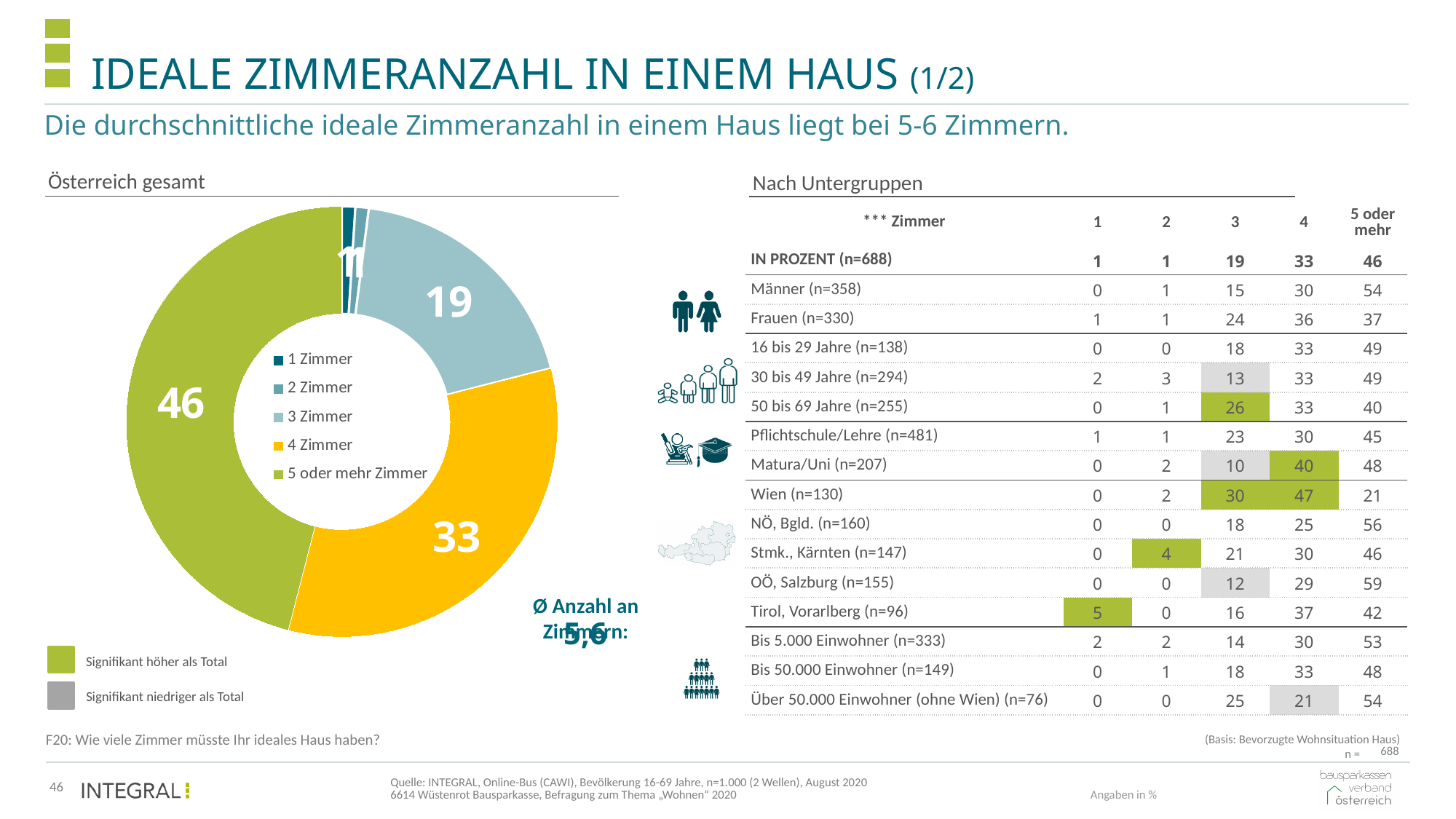
In the "Österreich gesamt" chart, what is the value for "3 Zimmer"? 19 In the "Österreich gesamt" chart, which category is larger: "3 Zimmer" or "4 Zimmer"? 4 Zimmer What average number of rooms (Ø Anzahl an Zimmern) is stated next to the "Österreich gesamt" chart? 5,6 In the "Österreich gesamt" chart, what is the difference between the values for "4 Zimmer" and "3 Zimmer"? 14 In the "Österreich gesamt" chart, what is the value for "5 oder mehr Zimmer"? 46 In the "Österreich gesamt" chart, what is the difference between the values for "5 oder mehr Zimmer" and "4 Zimmer"? 13 In the "Österreich gesamt" chart, what is the value for "1 Zimmer"? 1 In the "Österreich gesamt" chart, which category has the largest share? 5 oder mehr Zimmer In the "Österreich gesamt" chart, what colour is the "4 Zimmer" segment? Yellow How many categories does the legend of the "Österreich gesamt" chart list? 5 In the "Österreich gesamt" chart, what is the value for "4 Zimmer"? 33 What kind of chart is shown under "Österreich gesamt"? Donut (pie) chart